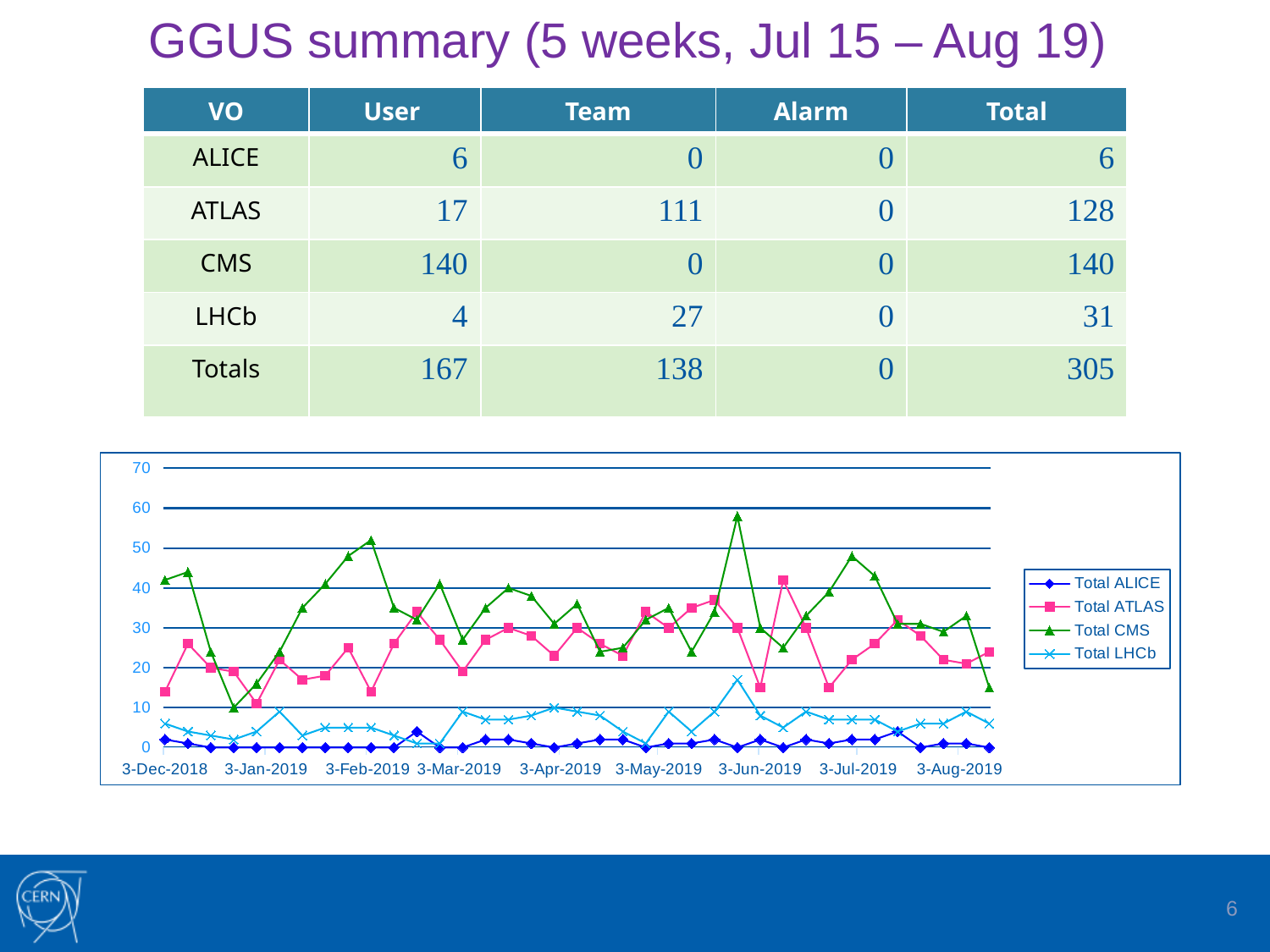
Is the peak value of Total CMS near 3-Jun-2019 greater or less than 50? greater Is the value for Total LHCb at 3-Jun-2019 greater or less than 20? less How many series does the chart's legend list? 4 Which series is listed first in the chart's legend? Total ALICE What kind of chart is shown on the slide? line chart What is the highest value shown on the y axis of the chart? 70 What is the last date label on the x axis of the chart? 3-Aug-2019 How many date labels are shown along the x axis of the chart? 9 Which series stays lowest across the chart? Total ALICE What is the first date label on the x axis of the chart? 3-Dec-2018 Which series is listed last in the chart's legend? Total LHCb Which series reaches the highest peak in the chart? Total CMS